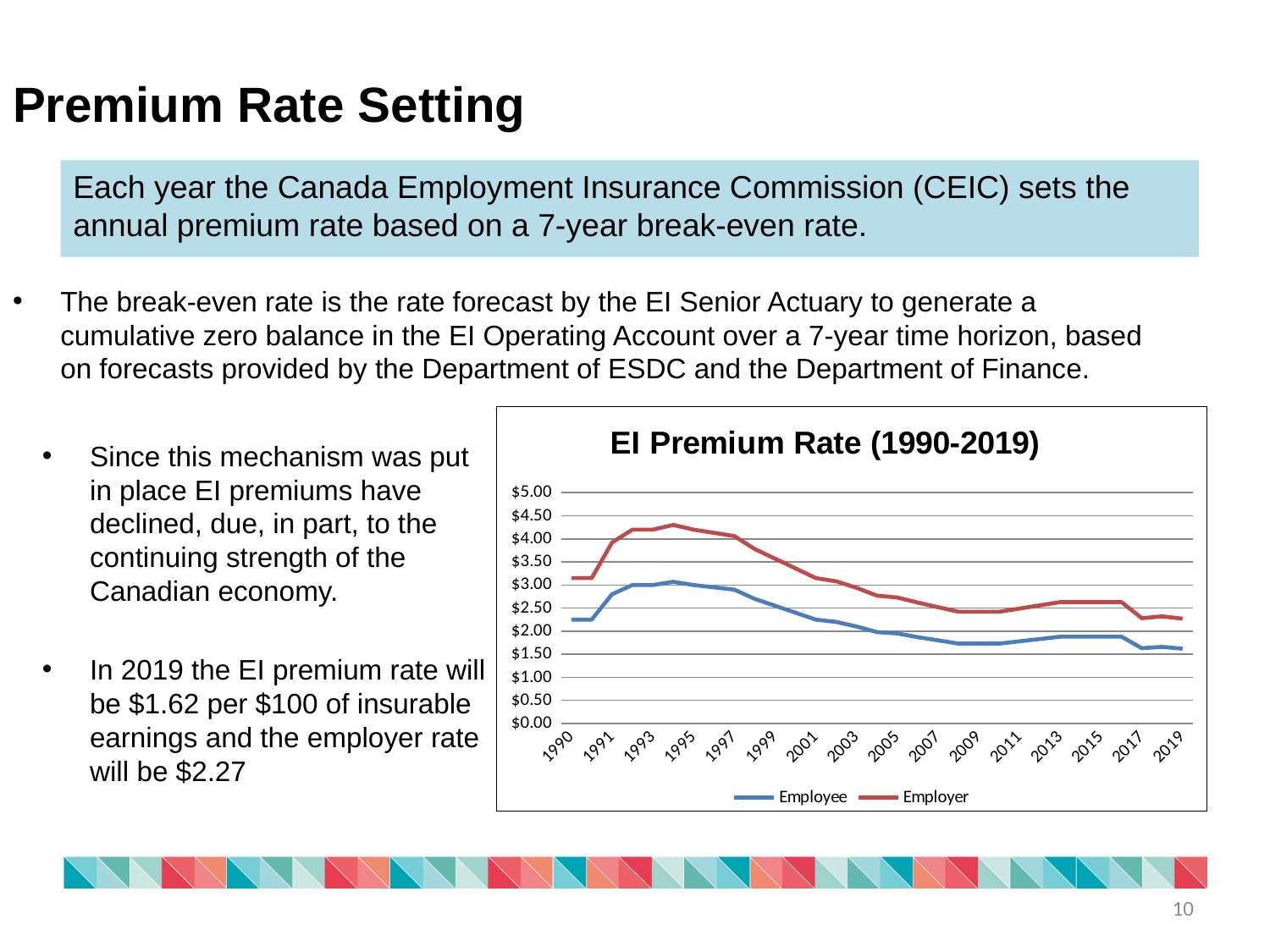
What is the title of the chart? EI Premium Rate (1990-2019) Which series has the higher premium rate in 2001, Employee or Employer? Employer Is the Employer premium rate in 1995 greater or less than $4.00? greater Which colour represents the Employer series in the chart? Red How many series does the chart legend list? 2 Do the premium rates rise or fall between 1997 and 2009? Fall Is the Employer premium rate in 2009 greater or less than $3.00? less Is the Employee premium rate in 1990 greater or less than $2.00? greater What type of chart is shown on the slide? Line chart According to the slide, what is the Employer EI premium rate in 2019? $2.27 According to the slide, what is the Employee EI premium rate in 2019? $1.62